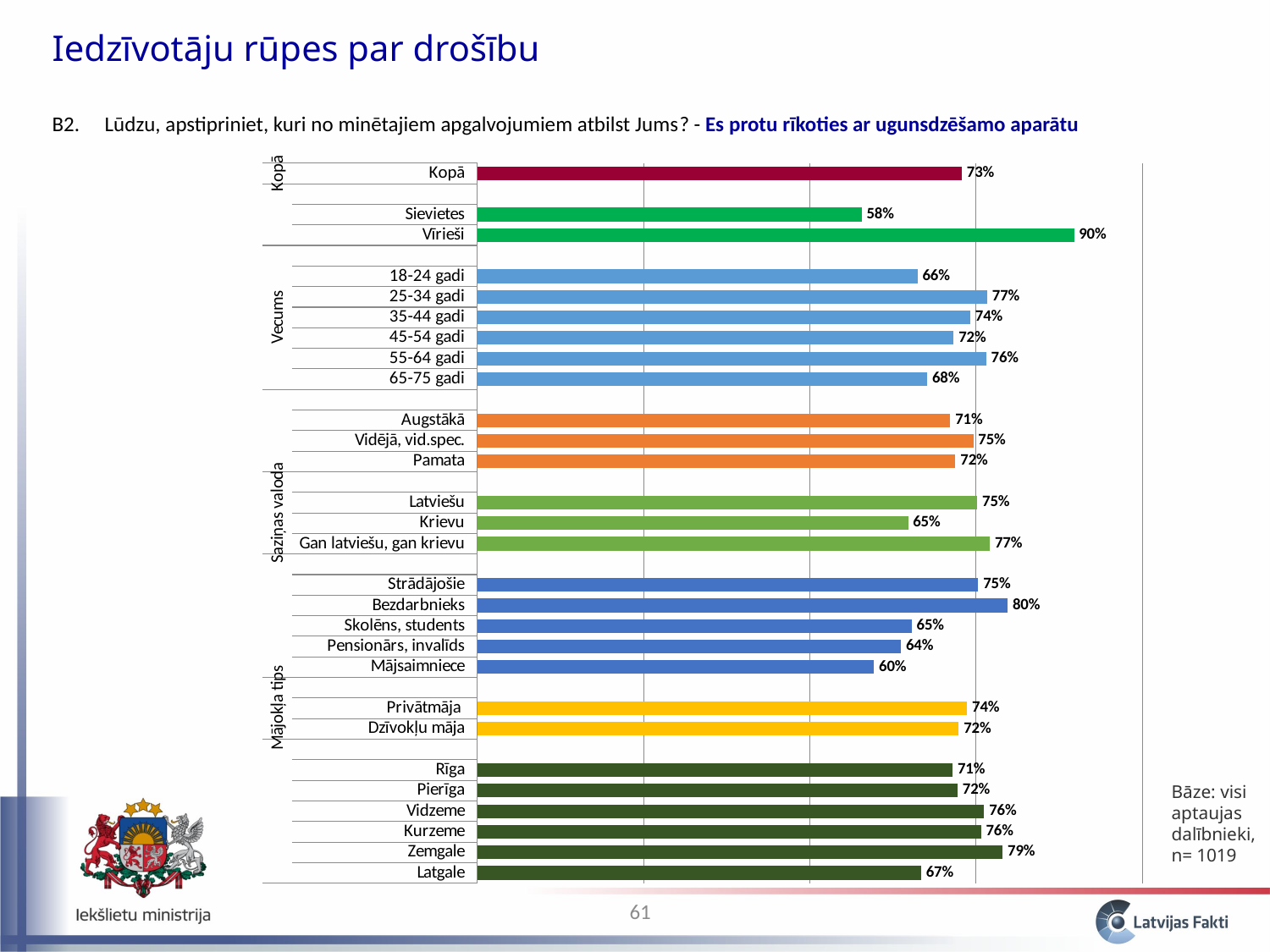
How many bars are plotted on the chart? 28 What kind of chart is shown on the slide? Bar chart What is the value for Kopā? 73% What is the difference between the values for Bezdarbnieks and Mājsaimniece? 20% What is the difference between the values for Vīrieši and Sievietes? 32% Which category has the highest value on the chart? Vīrieši Which is larger, the value for Zemgale or the value for Rīga? Zemgale Among the age groups (Vecums), which has the lowest value? 18-24 gadi What is the value for Latgale? 67% What is the value for Vīrieši? 90% What is the value for Bezdarbnieks? 80% Which category has the lowest value on the chart? Sievietes